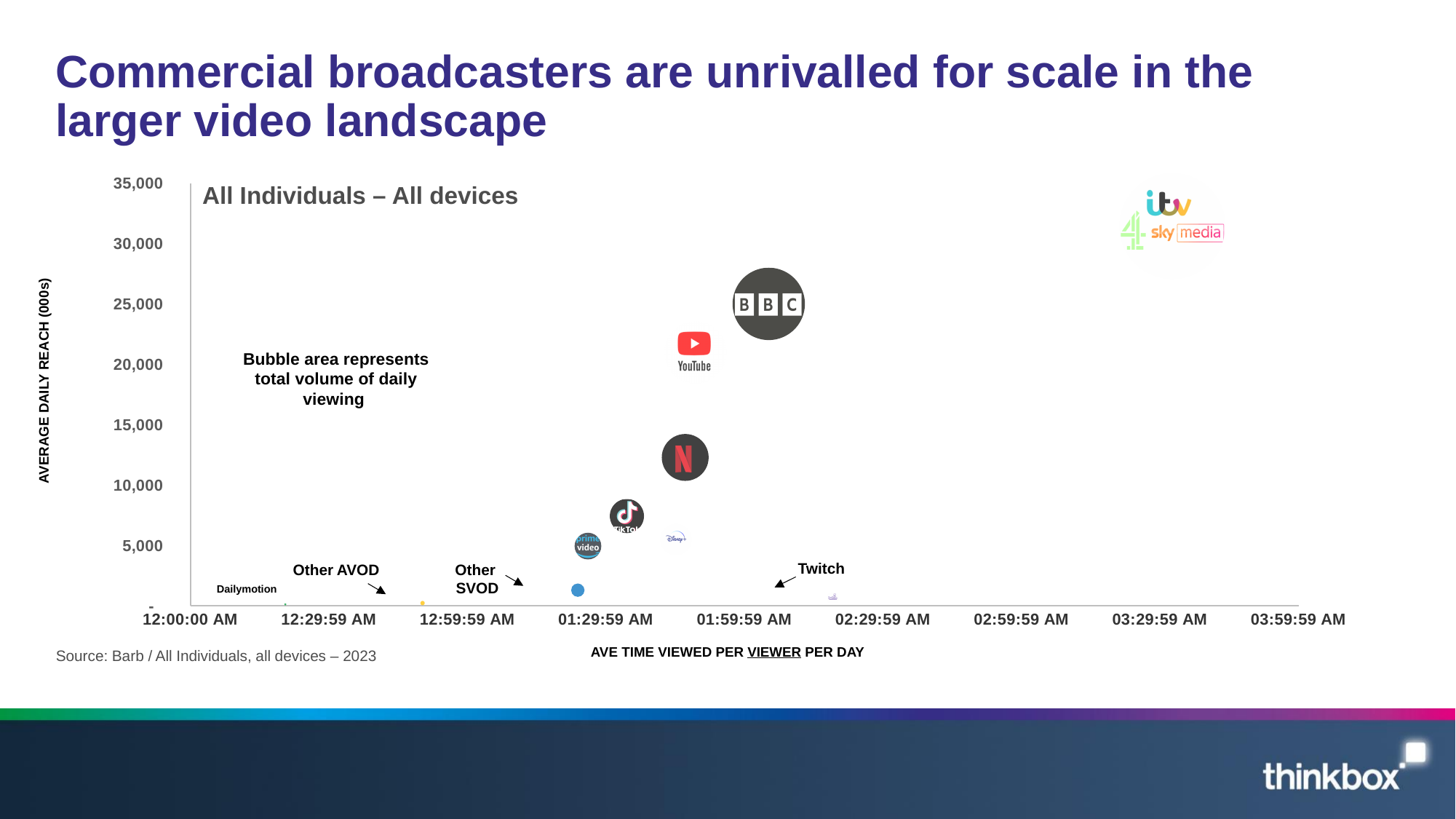
What does the bubble area represent in the chart? Total volume of daily viewing Is the average daily reach for Netflix greater or less than 10,000? greater Is the average daily reach for Twitch greater or less than 5,000? less What is the label on the vertical axis of the chart? AVERAGE DAILY REACH (000s) Is the average daily reach for TikTok greater or less than 10,000? less Which has the higher average daily reach, BBC or Netflix? BBC What kind of chart is shown on the slide? Bubble chart Which has the longer average time viewed per viewer per day, BBC or YouTube? BBC Which has the higher average daily reach, Netflix or TikTok? Netflix